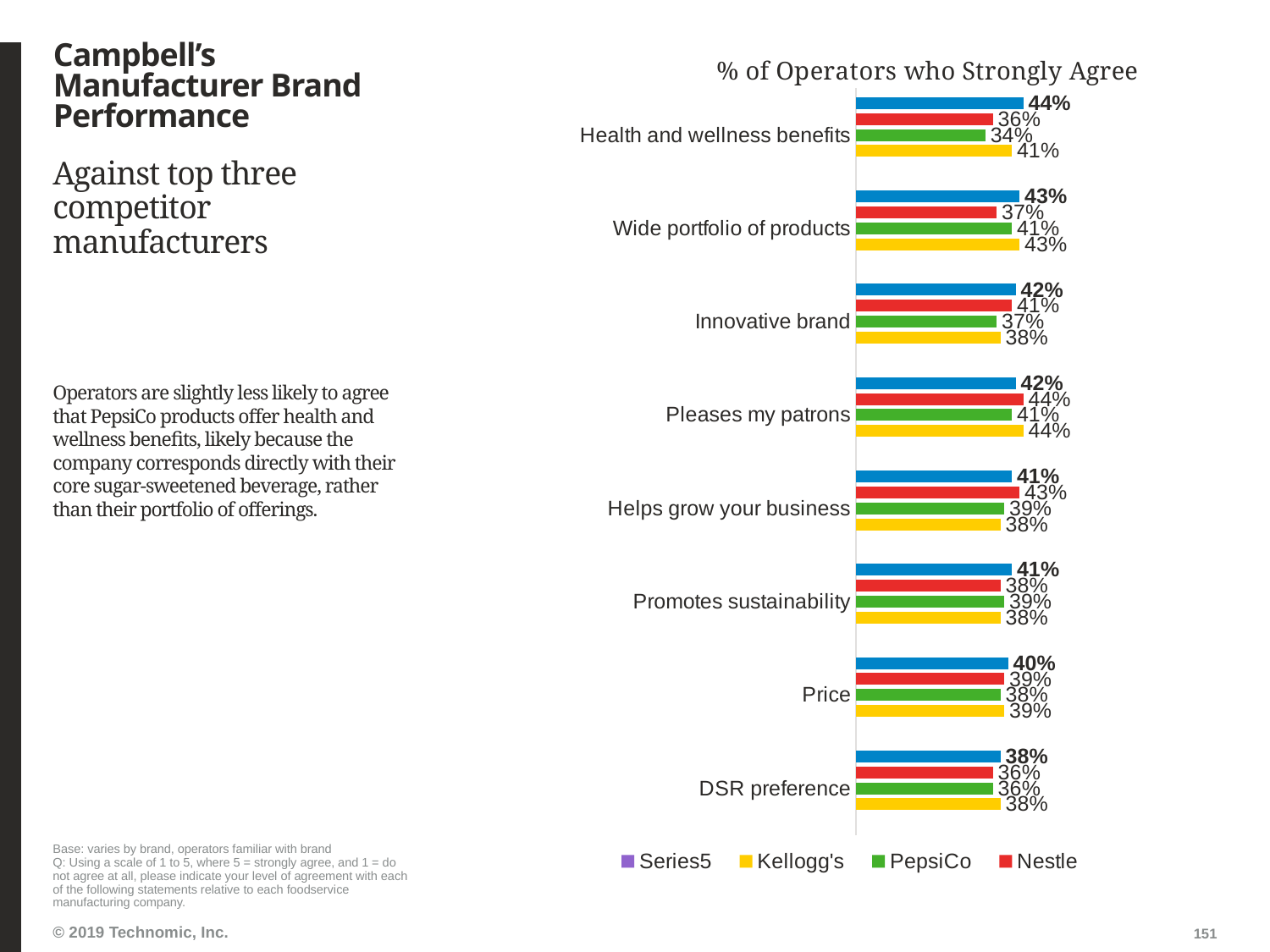
On which statement does Nestle have its highest percentage of operators who strongly agree? Pleases my patrons On 'Health and wellness benefits', how many percentage points higher is Kellogg's than PepsiCo? 7 percentage points On which statement does PepsiCo have its lowest percentage? Health and wellness benefits What type of chart is shown on the slide? Bar chart What percentage of operators strongly agree that PepsiCo offers health and wellness benefits? 34% What is the value for Kellogg's on 'Wide portfolio of products'? 43% What is Nestle's value for 'Pleases my patrons'? 44% How many series does the legend list? 4 How many statements (categories) are shown in the chart? 8 What is the title of the chart? % of Operators who Strongly Agree For 'Innovative brand', which is higher: Nestle or PepsiCo? Nestle What is Nestle's value for 'DSR preference'? 36%